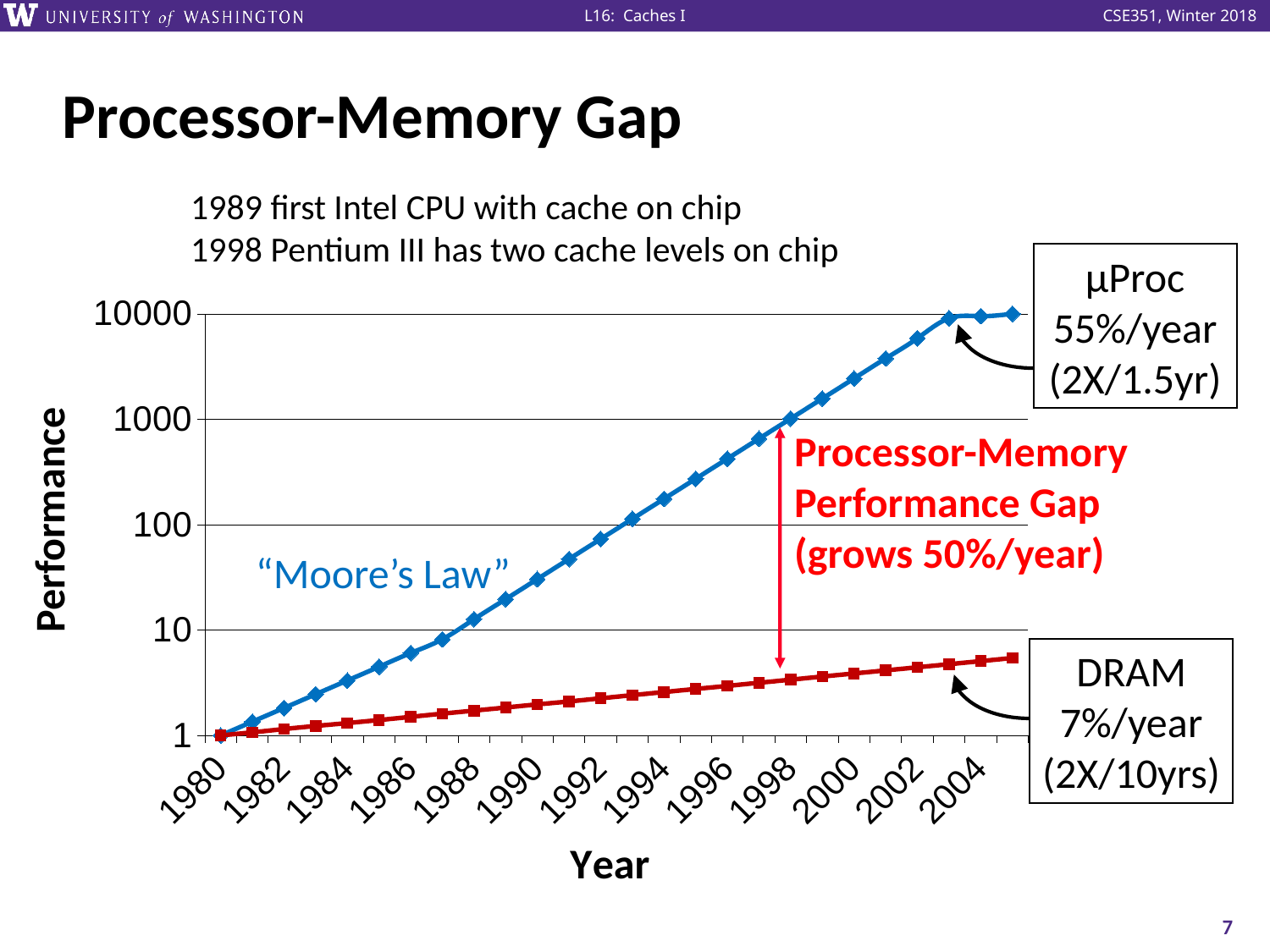
What is the label on the y axis of the chart? Performance What is the label on the x axis of the chart? Year Does the DRAM performance rise or fall from 1980 to 2004? rise Is the DRAM value in 2004 greater or less than 10? less Is the µProc value in 1990 greater or less than 10? greater Is the µProc value in 2004 greater or less than 1000? greater What kind of chart is shown on the slide? line chart How many data series are plotted in the chart? 2 How many year labels are shown along the x axis? 13 In 2000, which series has the higher performance value, µProc or DRAM? µProc